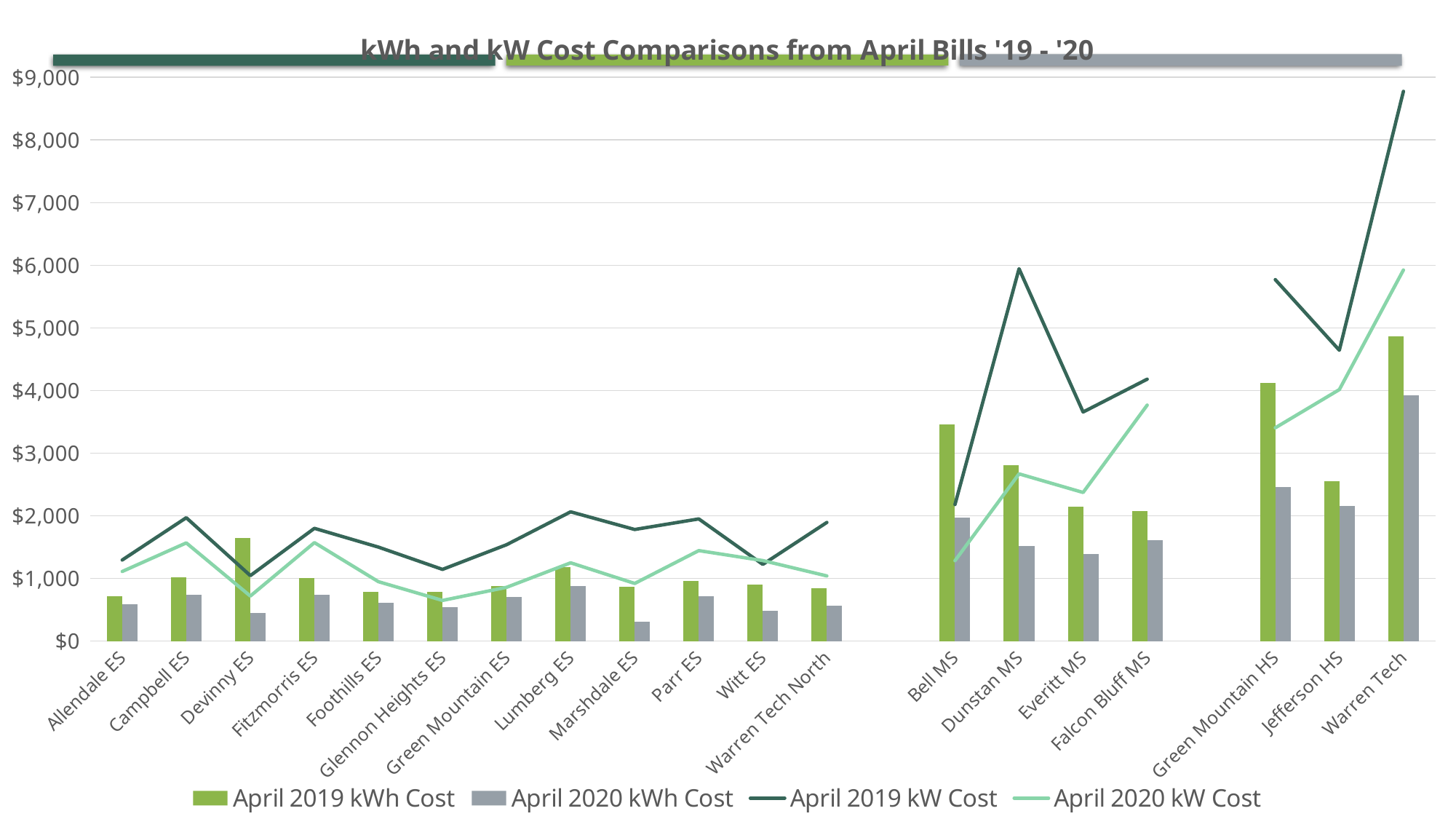
Which school has the highest April 2019 kWh Cost? Warren Tech Is the April 2019 kWh Cost for Bell MS greater or less than $3,000? greater Which school has the highest April 2019 kW Cost? Warren Tech How many schools are shown along the x axis? 19 Is the April 2019 kW Cost for Warren Tech greater or less than $8,000? greater Is the April 2019 kW Cost for Dunstan MS greater or less than $5,000? greater What is the title of the chart? kWh and kW Cost Comparisons from April Bills '19 - '20 Which school has the lowest April 2020 kWh Cost? Marshdale ES Does the April 2020 kW Cost rise or fall from Green Mountain HS to Warren Tech? rise What kind of chart is this? Combined bar and line chart How many series does the legend list? 4 Which is larger, the April 2019 kWh Cost for Green Mountain HS or for Jefferson HS? Green Mountain HS